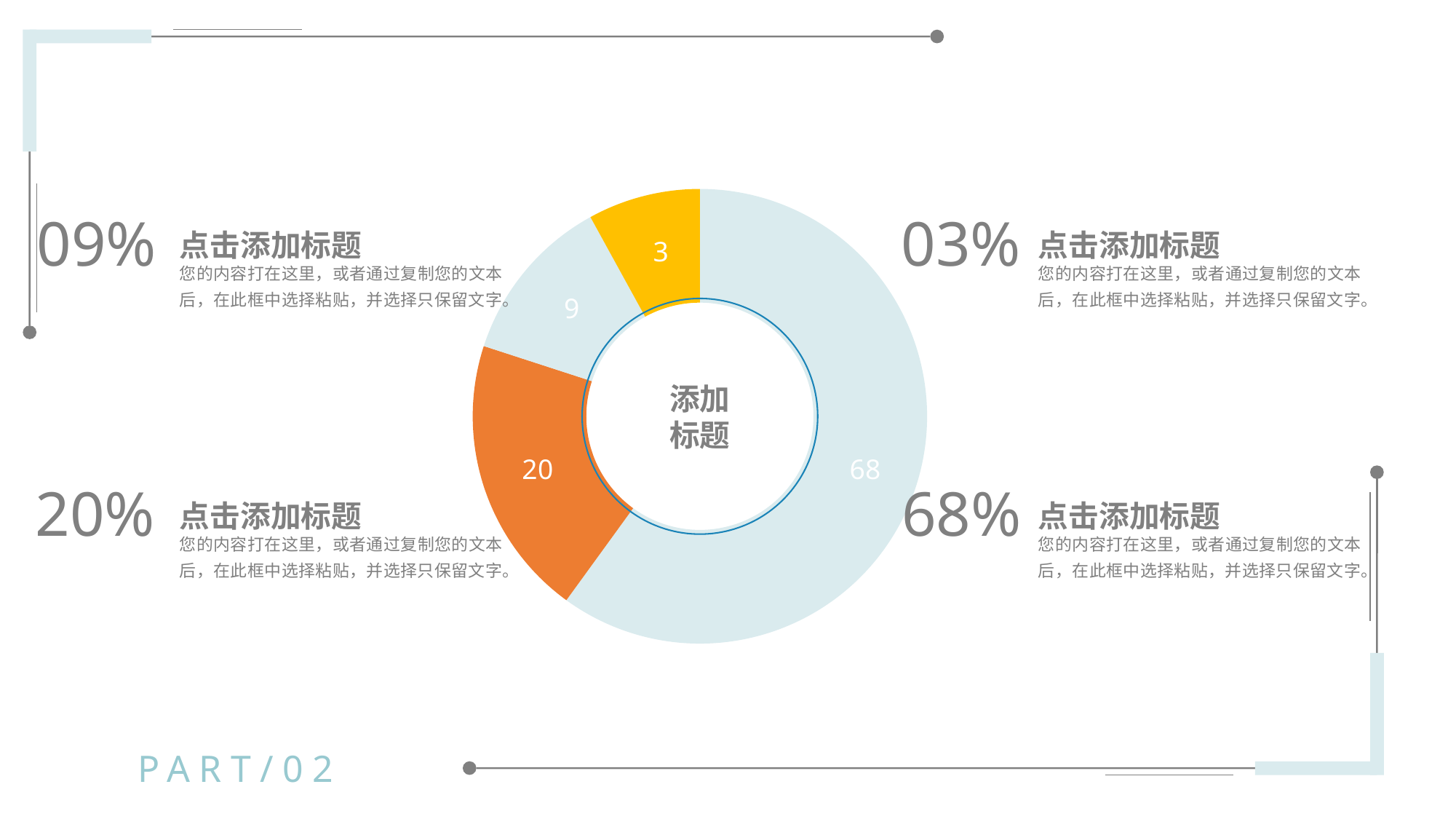
Which is larger, the orange slice or the yellow slice? the orange slice What is the difference between the slice labelled 9 and the slice labelled 3? 6 What value is printed on the yellow slice of the doughnut chart? 3 What is the difference between the largest slice (68) and the orange slice (20)? 48 What is the value of the smallest slice in the doughnut chart? 3 What kind of chart is shown on the slide? doughnut chart What is the value of the largest slice in the doughnut chart? 68 What value is printed on the orange slice of the doughnut chart? 20 What text is shown in the centre of the doughnut chart? 添加标题 How many slices does the doughnut chart have? 4 What is the total of all four slice values in the doughnut chart? 100 What share of the doughnut does the slice labelled 20 represent? 20%